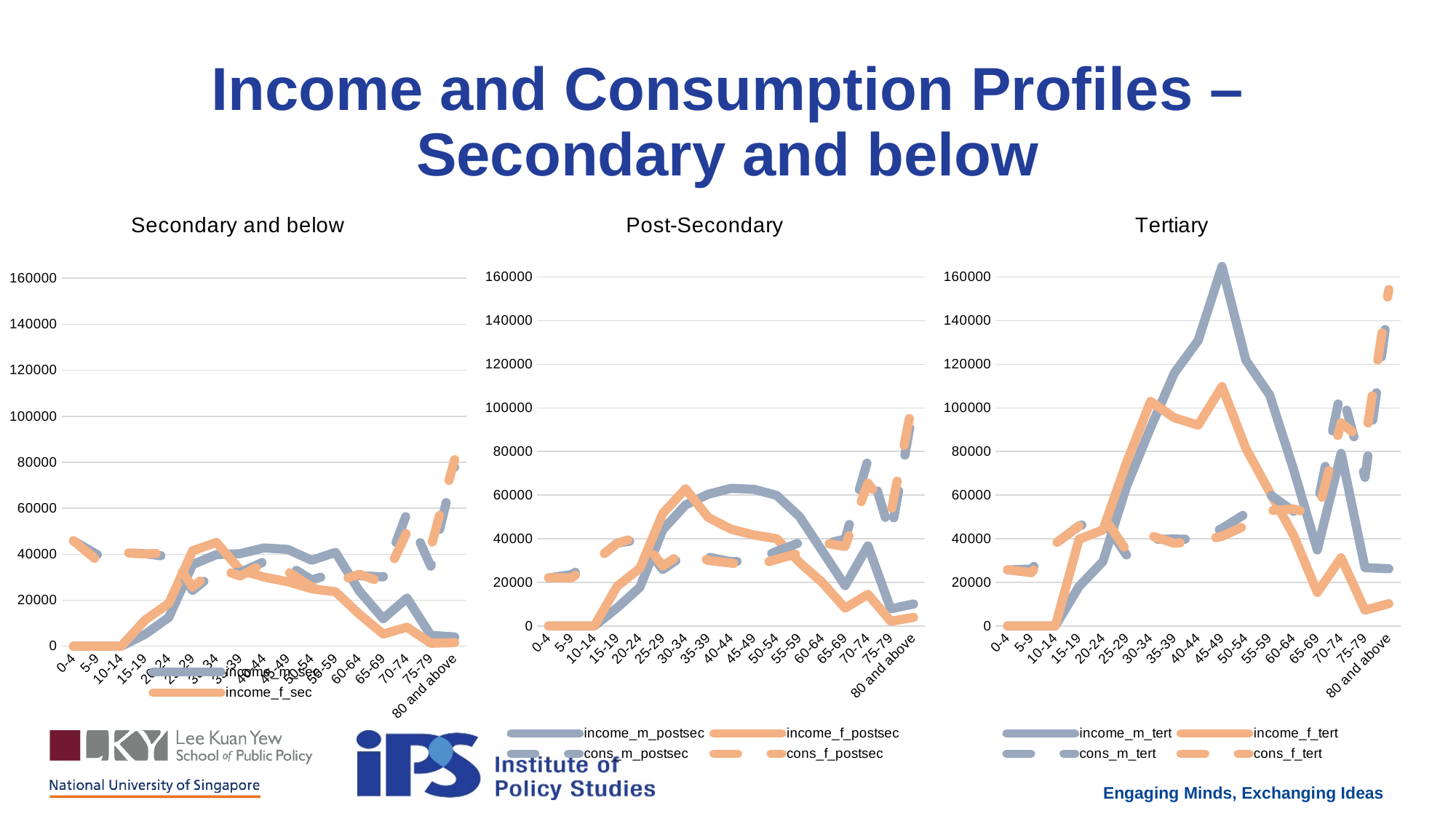
How many series does the legend of the Tertiary chart list? 4 In the Tertiary chart, at 45-49, which is larger: income_m_tert or income_f_tert? income_m_tert How many age-group categories are shown on the x axis of the Post-Secondary chart? 17 What is the title of the chart on the right of the slide? Tertiary In the Post-Secondary chart, is the value of income_m_postsec for 40-44 greater or less than 40000? greater In the Secondary and below chart, at 20-24, which is larger: income_f_sec or income_m_sec? income_f_sec In the Tertiary chart, is the value of income_f_tert for 30-34 greater or less than 80000? greater In the Tertiary chart, which age group has the highest value for income_m_tert? 45-49 How many series does the legend of the Post-Secondary chart list? 4 What kind of chart is the Tertiary chart? line chart In the Tertiary chart, does income_m_tert rise or fall from 45-49 to 65-69? fall In the Tertiary chart, is the value of income_m_tert for 45-49 greater or less than 140000? greater